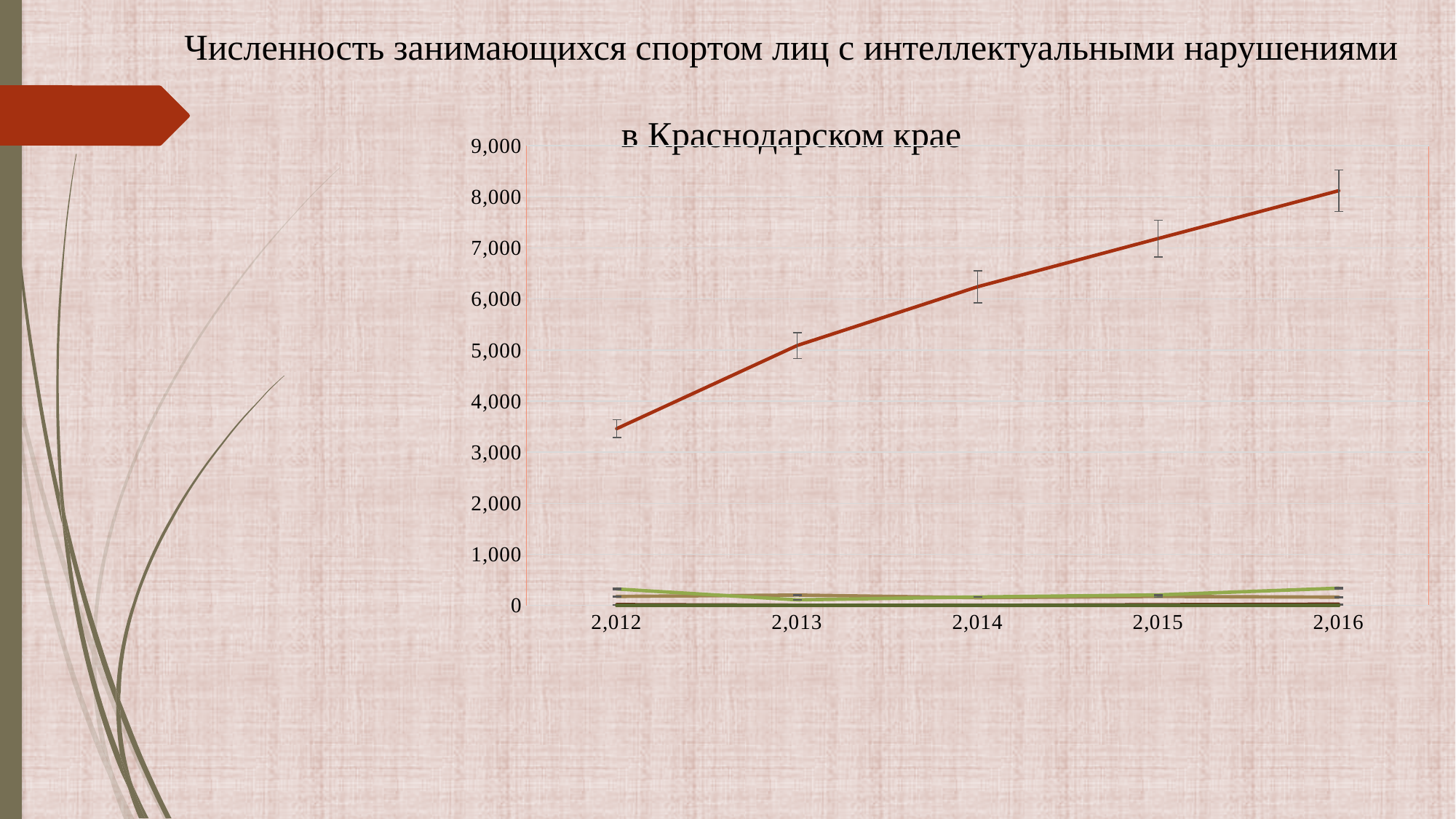
Which year has the larger value on the red line, 2,012 or 2,016? 2,016 What kind of chart is shown on the slide? line chart How many years are shown on the x axis of the chart? 5 Is the value of the red line in 2,013 greater or less than 4,000? greater What is the highest value shown on the y axis of the chart? 9,000 In which year does the red (topmost) line have its lowest value? 2,012 In which year does the red (topmost) line reach its highest value? 2,016 Is the value of the red line in 2,014 greater or less than 5,000? greater Does the red (topmost) line rise or fall from 2,012 to 2,016? rises Is the value of the red line in 2,012 greater or less than 4,000? less